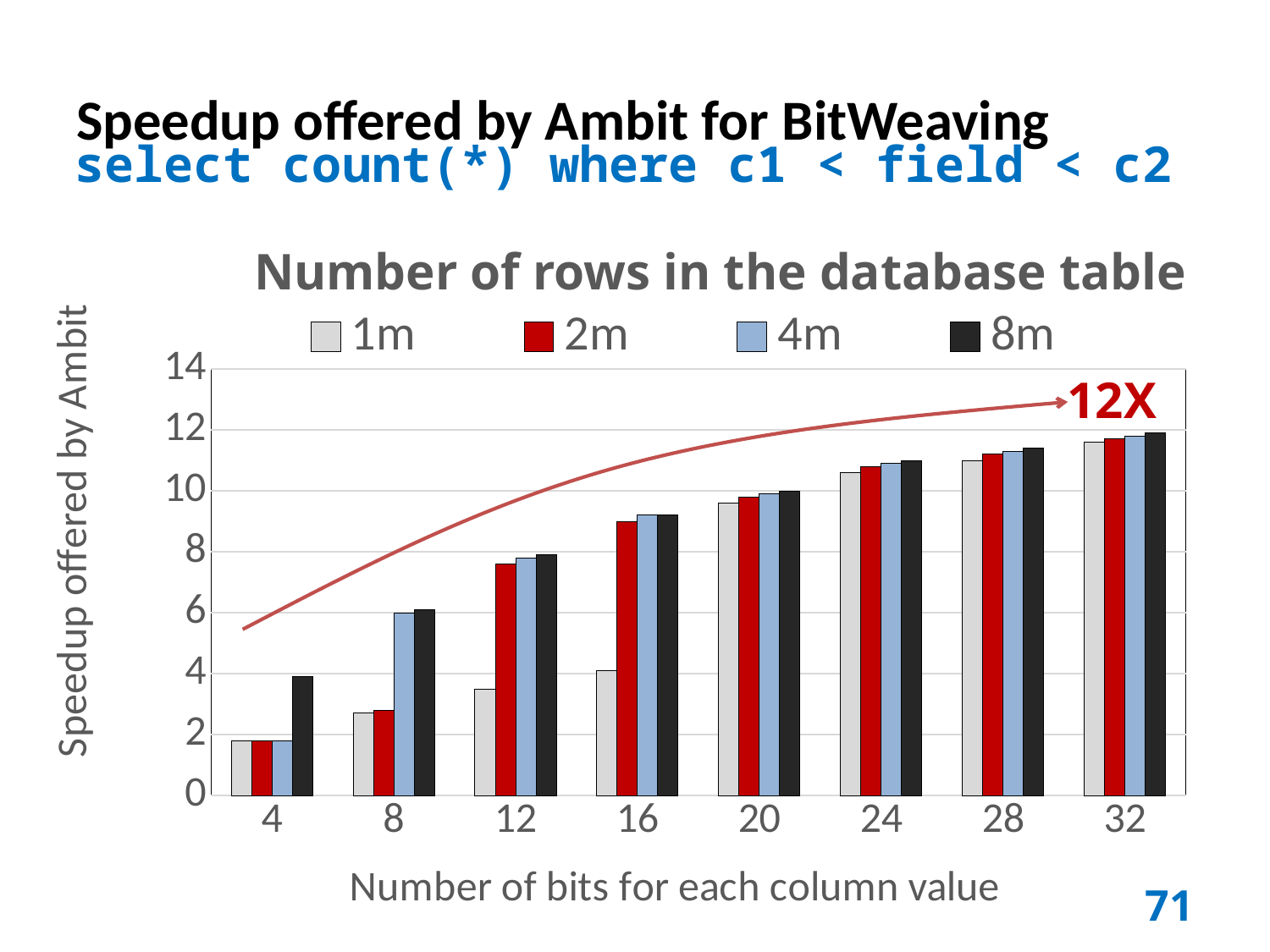
At 4 bits, which is larger: the value for 1m or the value for 8m? 8m Is the value for 2m at 12 bits greater or less than 8? less At 8 bits, which is larger: the value for 2m or the value for 4m? 4m Do the speedup values rise or fall as the number of bits increases? rise Is the value for 1m at 4 bits greater or less than 2? less What does the legend title say the series represent? Number of rows in the database table How many series does the legend list? 4 Is the value for 1m at 20 bits greater or less than 10? less For the 1m series, at which number of bits is the speedup highest? 32 How many categories are shown on the x axis? 8 What kind of chart is shown on the slide? bar chart